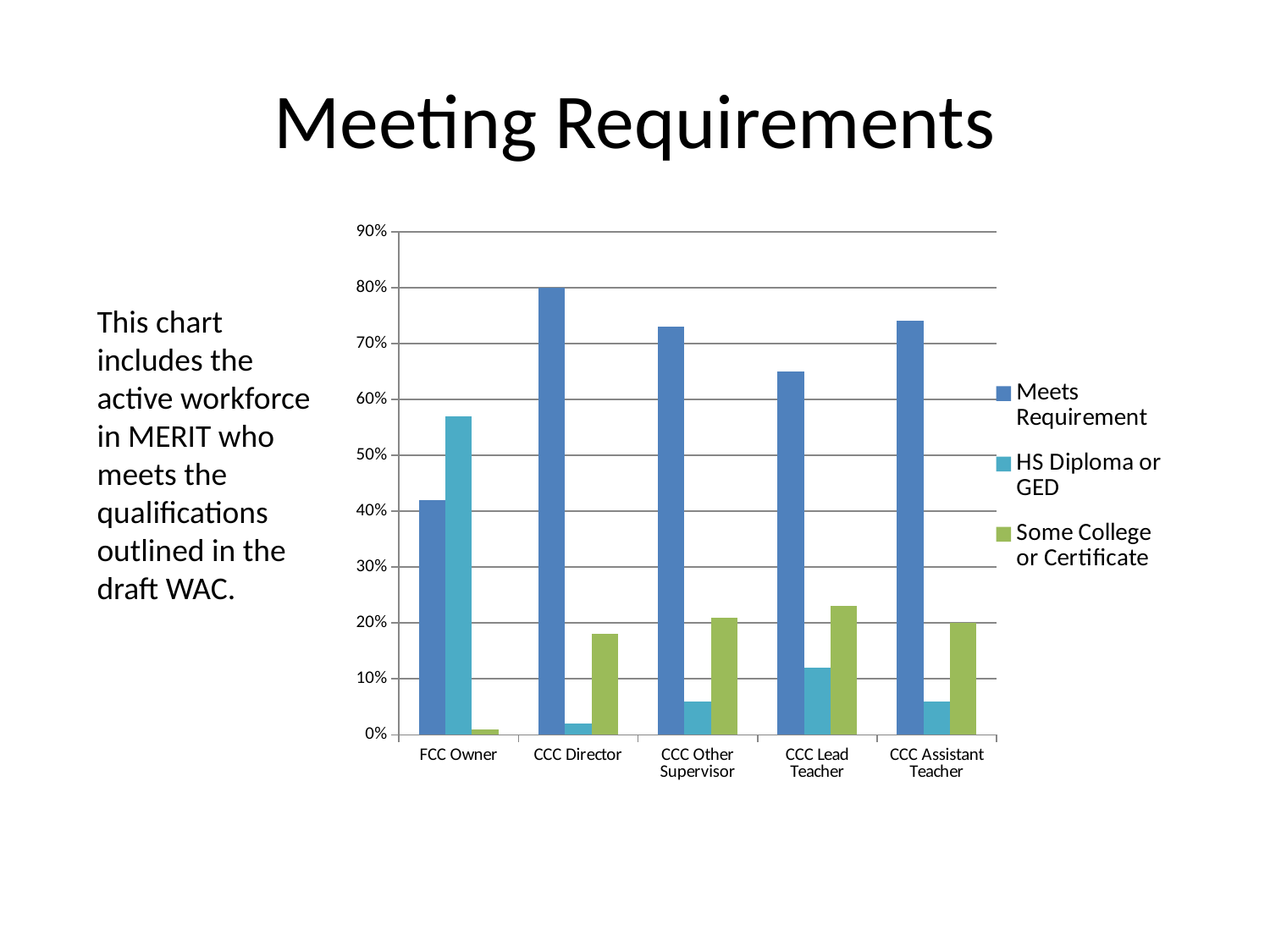
What type of chart is shown on the slide? bar chart Is the Meets Requirement value for CCC Lead Teacher greater or less than 60%? greater Which category has the highest HS Diploma or GED value? FCC Owner What is the Meets Requirement value for CCC Director? 80% How many series does the legend list? 3 For FCC Owner, which is larger: Meets Requirement or HS Diploma or GED? HS Diploma or GED Which category has the highest Meets Requirement value? CCC Director Which category has the lowest Some College or Certificate value? FCC Owner Is the HS Diploma or GED value for CCC Assistant Teacher greater or less than 10%? less How many categories are shown on the x axis? 5 Which category has the lowest Meets Requirement value? FCC Owner Which is larger for Meets Requirement: CCC Director or CCC Lead Teacher? CCC Director